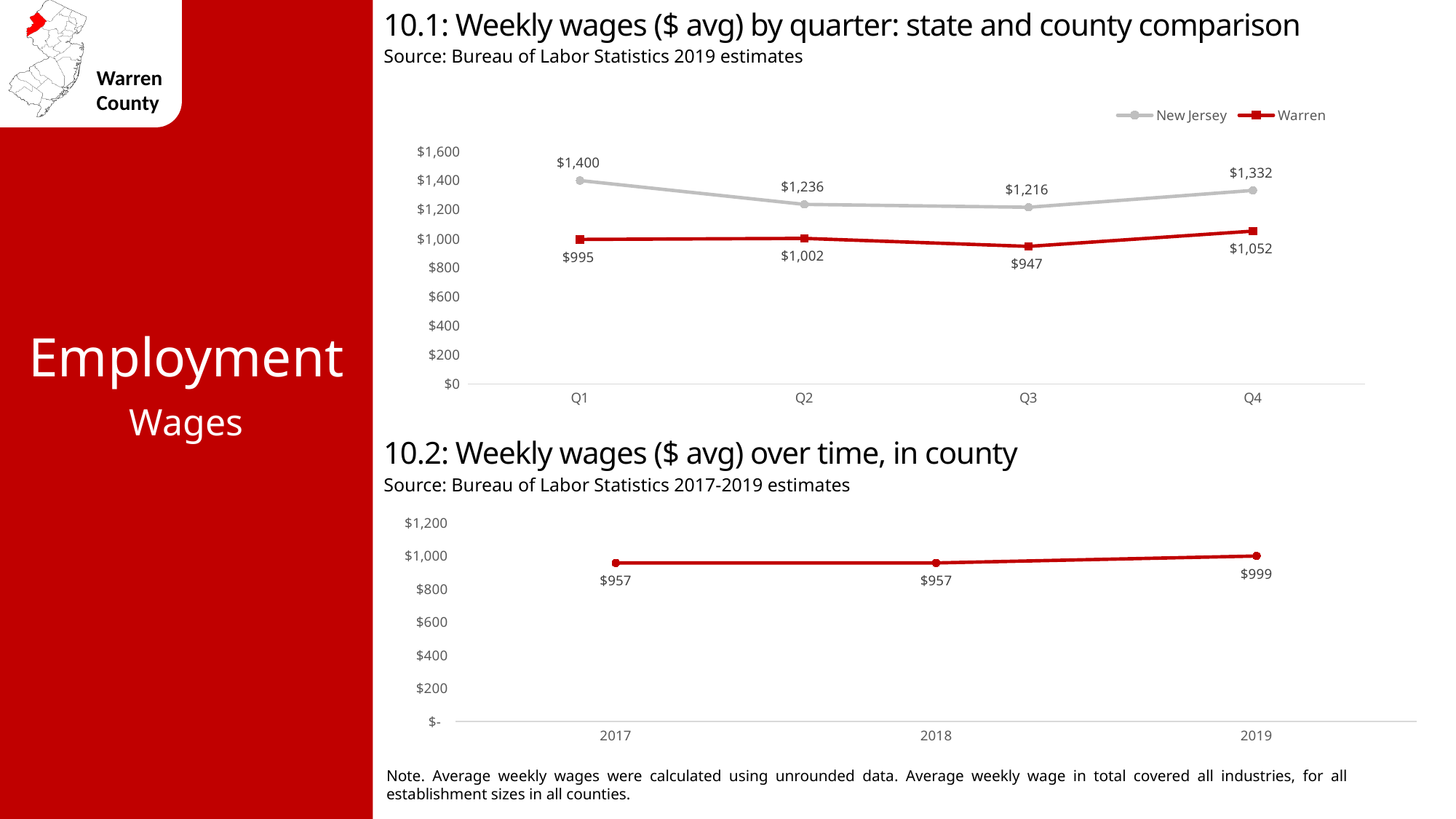
In chart 10.2 (Weekly wages over time, in county), is the value for 2017 greater or less than $1,000? less In chart 10.1 (Weekly wages by quarter: state and county comparison), which is larger in Q2: the New Jersey value or the Warren value? New Jersey In chart 10.1 (Weekly wages by quarter: state and county comparison), how many series does the legend list? 2 In chart 10.1 (Weekly wages by quarter: state and county comparison), what is the New Jersey value for Q1? $1,400 In chart 10.2 (Weekly wages over time, in county), what is the value for 2019? $999 In chart 10.1 (Weekly wages by quarter: state and county comparison), what is the Warren value for Q3? $947 In chart 10.1 (Weekly wages by quarter: state and county comparison), in which quarter is the Warren value highest? Q4 In chart 10.2 (Weekly wages over time, in county), what is the difference between the 2019 and 2018 values? $42 In chart 10.1 (Weekly wages by quarter: state and county comparison), what is the difference between the New Jersey and Warren values in Q4? $280 In chart 10.1 (Weekly wages by quarter: state and county comparison), what kind of chart is it? Line chart In chart 10.1 (Weekly wages by quarter: state and county comparison), in which quarter is the New Jersey value lowest? Q3 In chart 10.2 (Weekly wages over time, in county), how many years are plotted? 3